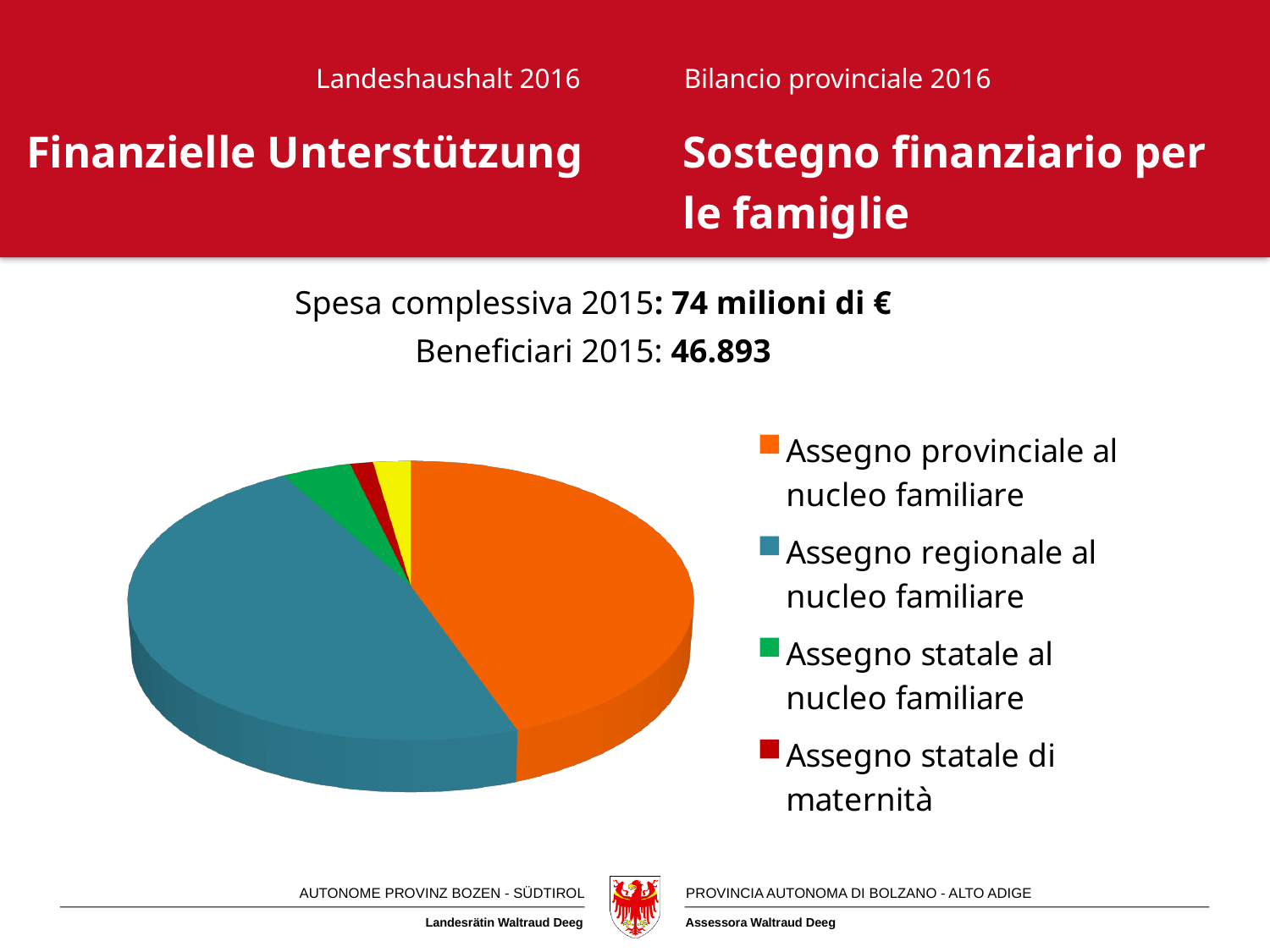
What colour is the slice for Assegno provinciale al nucleo familiare? orange What kind of chart is shown on the slide? pie chart Which legend category has the smallest slice in the pie chart? Assegno statale di maternità Which slice is larger: Assegno statale al nucleo familiare or Assegno statale di maternità? Assegno statale al nucleo familiare Which slice is larger: Assegno regionale al nucleo familiare or Assegno statale al nucleo familiare? Assegno regionale al nucleo familiare Which slice is larger: Assegno provinciale al nucleo familiare or Assegno statale al nucleo familiare? Assegno provinciale al nucleo familiare What colour is the slice for Assegno regionale al nucleo familiare? teal blue How many entries does the chart's legend list? 4